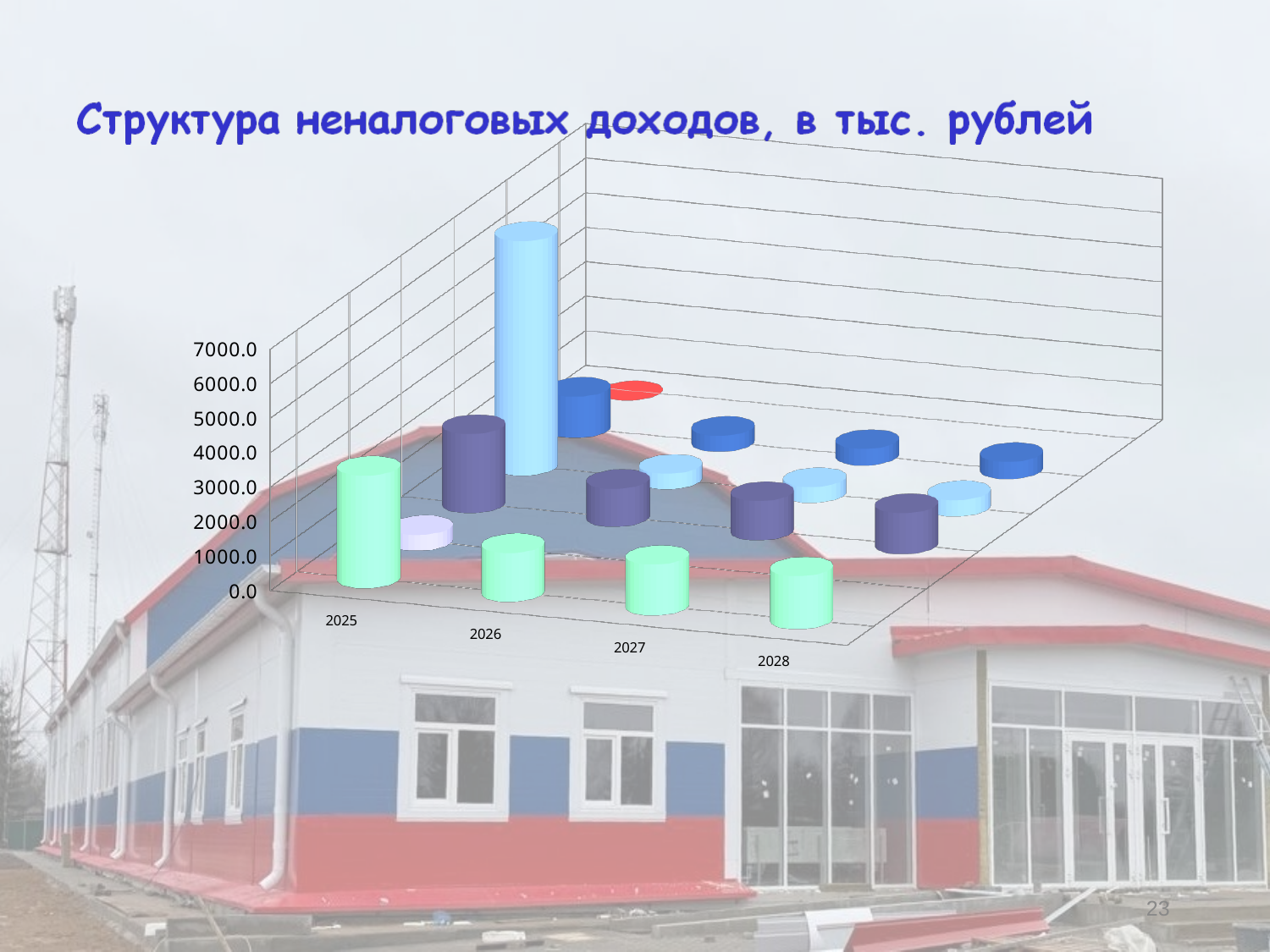
Do the values of the green (front) series rise or fall from 2025 to 2028? fall Which year has the tallest bar in the chart? 2025 How many years are shown on the x axis of the chart? 4 What kind of chart is shown on the slide? bar chart What is the highest value shown on the vertical axis of the chart? 7000.0 Which is larger: the green bar for 2025 or the green bar for 2027? 2025 Is the value of the green bar for 2028 greater or less than 2000? less What is the title of the chart? Структура неналоговых доходов, в тыс. рублей Is the value of the green bar for 2025 greater or less than 2000? greater